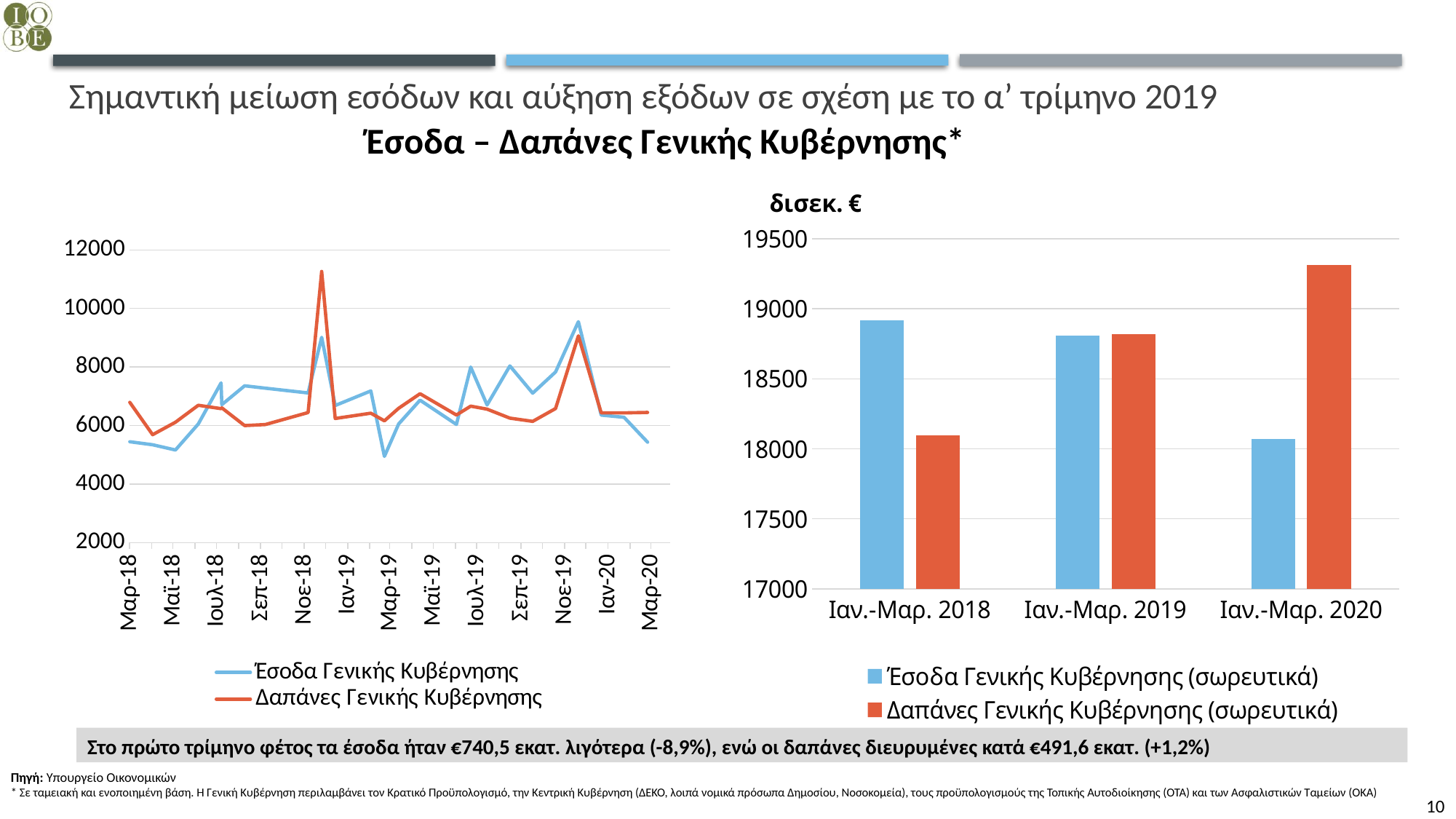
In the right-hand bar chart, for Ιαν.-Μαρ. 2018, which is larger: Έσοδα or Δαπάνες Γενικής Κυβέρνησης (σωρευτικά)? Έσοδα Γενικής Κυβέρνησης (σωρευτικά) In the right-hand bar chart, do the Δαπάνες Γενικής Κυβέρνησης (σωρευτικά) bars rise or fall from Ιαν.-Μαρ. 2018 to Ιαν.-Μαρ. 2020? rise In the right-hand bar chart, which period has the highest bar for Δαπάνες Γενικής Κυβέρνησης (σωρευτικά)? Ιαν.-Μαρ. 2020 In the right-hand bar chart, which period has the lowest bar for Έσοδα Γενικής Κυβέρνησης (σωρευτικά)? Ιαν.-Μαρ. 2020 In the right-hand bar chart, how many categories are shown on the x axis? 3 What kind of chart is the left-hand chart (Μαρ-18 to Μαρ-20)? line chart What kind of chart is the right-hand chart (Ιαν.-Μαρ. 2018–2020)? bar chart In the right-hand bar chart, how many series does the legend list? 2 In the right-hand bar chart, is the value for Δαπάνες Γενικής Κυβέρνησης (σωρευτικά) in Ιαν.-Μαρ. 2020 greater or less than 19000? greater In the left-hand line chart, which colour is used for the Δαπάνες Γενικής Κυβέρνησης line? orange/red In the right-hand bar chart, is the value for Έσοδα Γενικής Κυβέρνησης (σωρευτικά) in Ιαν.-Μαρ. 2020 greater or less than 18500? less In the left-hand line chart, is the value of Έσοδα Γενικής Κυβέρνησης at Μαρ-19 greater or less than 6000? less